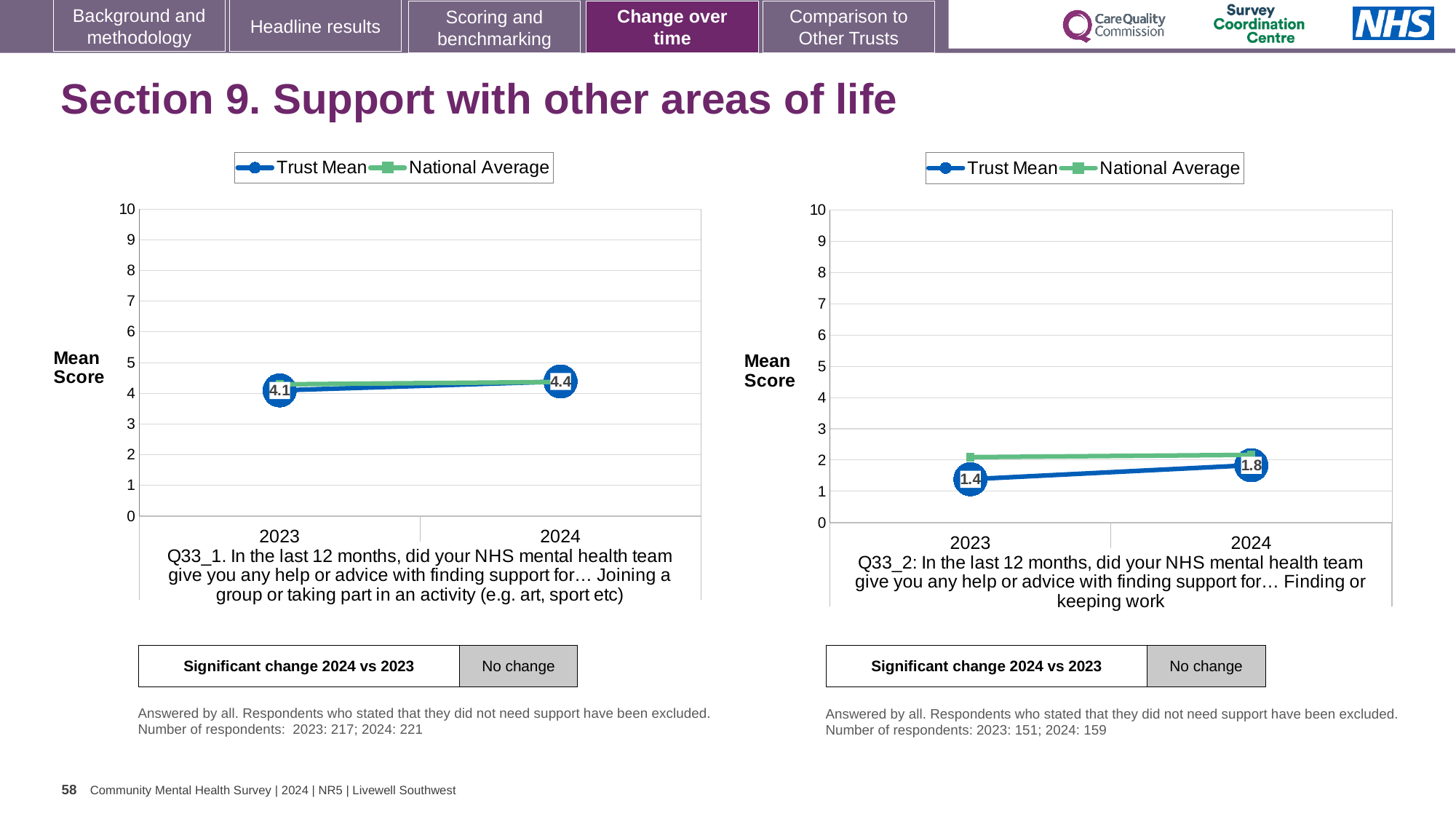
How many years are shown on the x axis of the left chart (Q33_1)? 2 What kind of chart is the left chart (Q33_1)? line chart On the right chart (Q33_2), what is the Trust Mean for 2024? 1.8 On the left chart (Q33_1), which series is shown in green? National Average On the left chart (Q33_1), what is the Trust Mean for 2024? 4.4 On the right chart (Q33_2), is the National Average for 2023 greater or less than 3? less On the right chart (Q33_2), does the Trust Mean rise or fall from 2023 to 2024? rise On the left chart (Q33_1), by how much did the Trust Mean change from 2023 to 2024? 0.3 On the left chart (Q33_1), what is the Trust Mean for 2023? 4.1 On the right chart (Q33_2), by how much did the Trust Mean change from 2023 to 2024? 0.4 How many series does the legend of the right chart (Q33_2) list? 2 On the right chart (Q33_2), what is the Trust Mean for 2023? 1.4